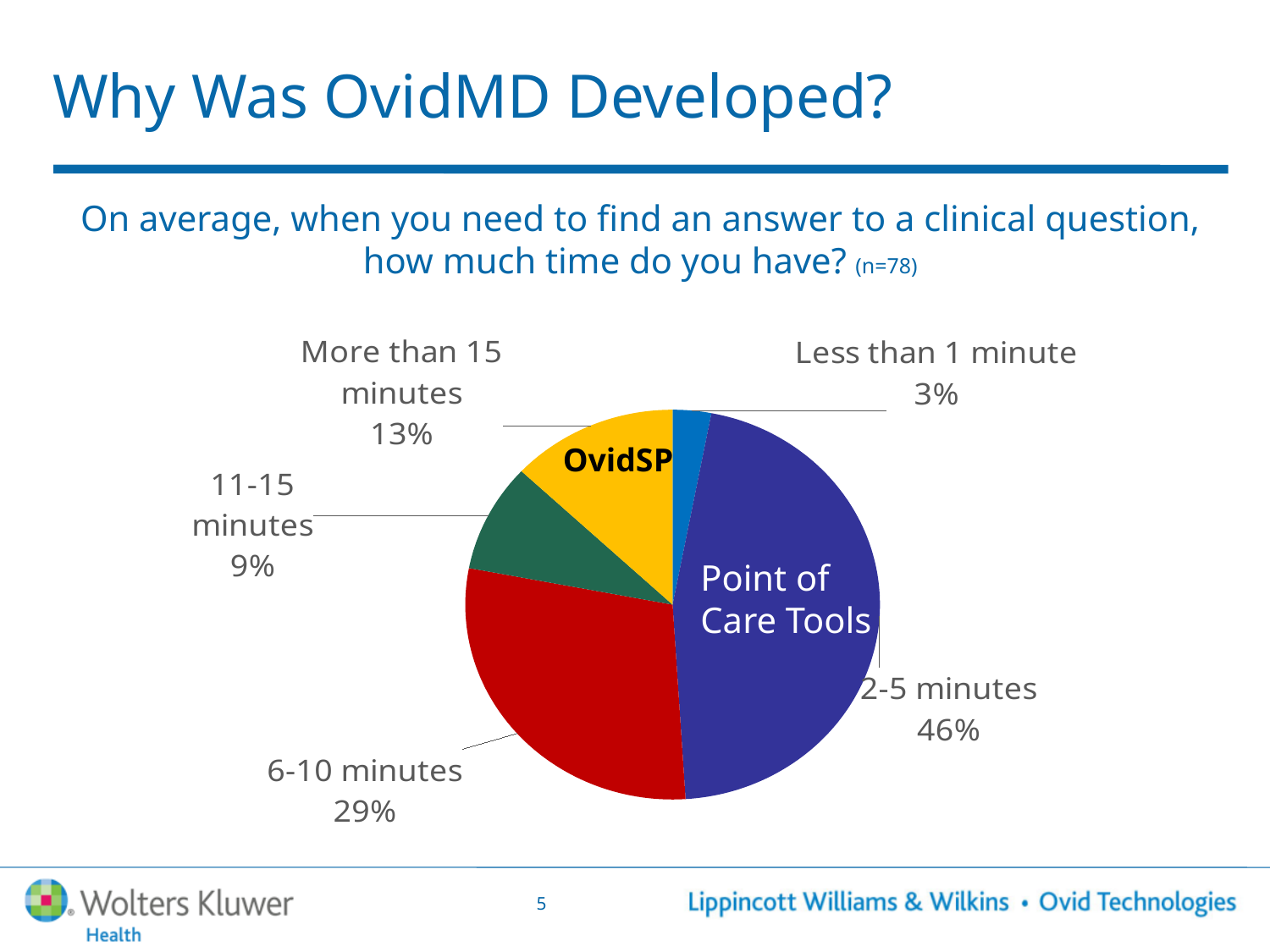
How many respondents (n) does the chart's question note? 78 How many slices does the pie chart have? 5 What is the difference in percentage points between the 2-5 minutes slice and the 6-10 minutes slice? 17 Which time category has the largest share of the pie? 2-5 minutes What percentage of respondents said they have 6-10 minutes? 29% What percentage of respondents said they have 11-15 minutes? 9% What percentage of respondents said they have more than 15 minutes? 13% Which slice is larger: 11-15 minutes or more than 15 minutes? More than 15 minutes What percentage of respondents said they have less than 1 minute? 3% What percentage of respondents said they have 2-5 minutes? 46% Which time category has the smallest share of the pie? Less than 1 minute What kind of chart is shown on the slide? pie chart